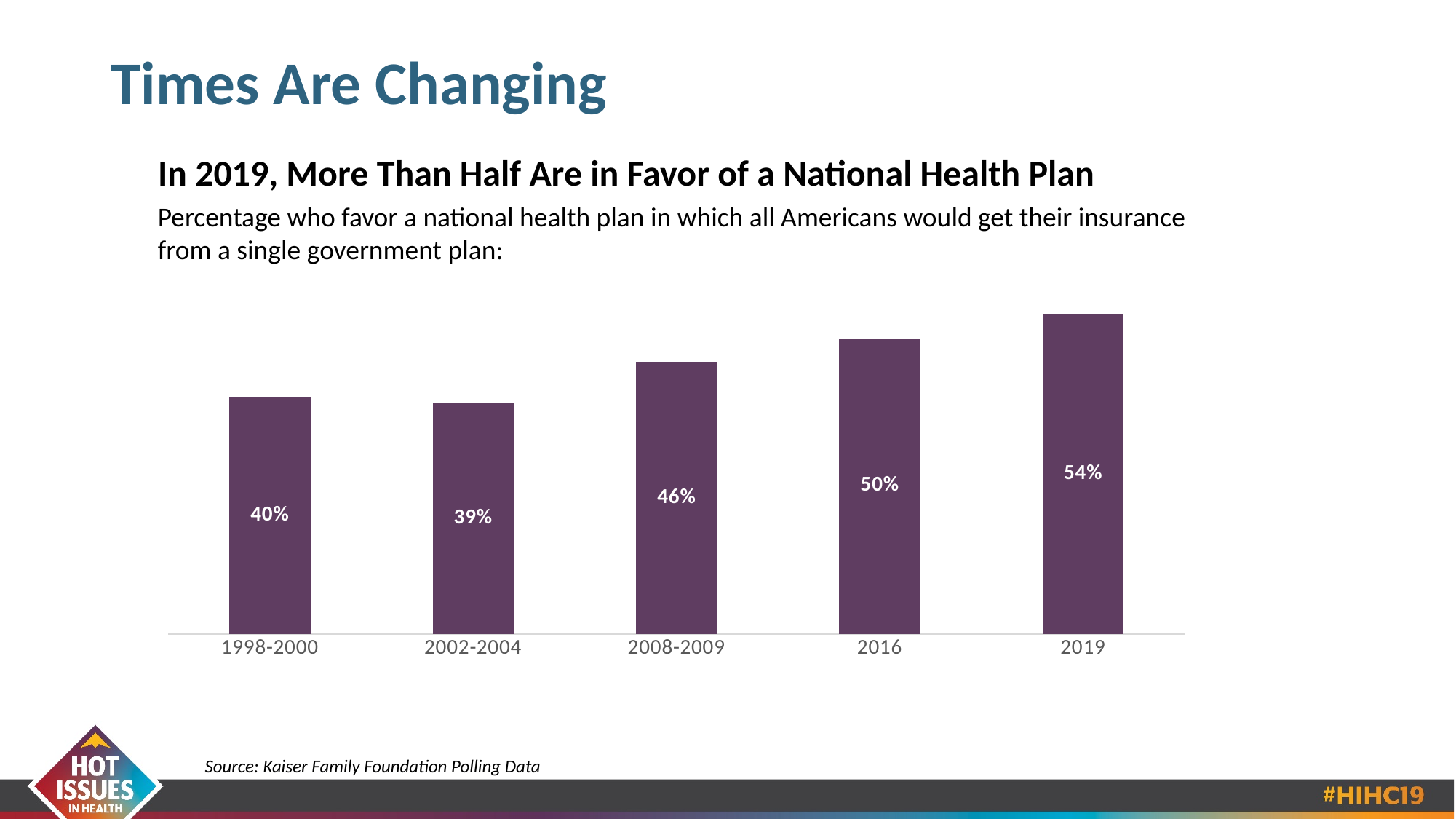
Do the values generally rise or fall from 2002-2004 to 2019? Rise What is the value shown for 1998-2000? 40% What is the value shown for 2008-2009? 46% Which is larger, the value for 1998-2000 or the value for 2002-2004? 1998-2000 What is the difference between the 2008-2009 value and the 2002-2004 value? 7% What is the difference between the 2019 value and the 2016 value? 4% Which period has the highest percentage in favor? 2019 Which period has the lowest percentage in favor? 2002-2004 What kind of chart is shown on the slide? Bar chart How many periods are shown on the x axis? 5 What percentage favored a national health plan in 2019? 54% What is the source cited for the chart data? Kaiser Family Foundation Polling Data